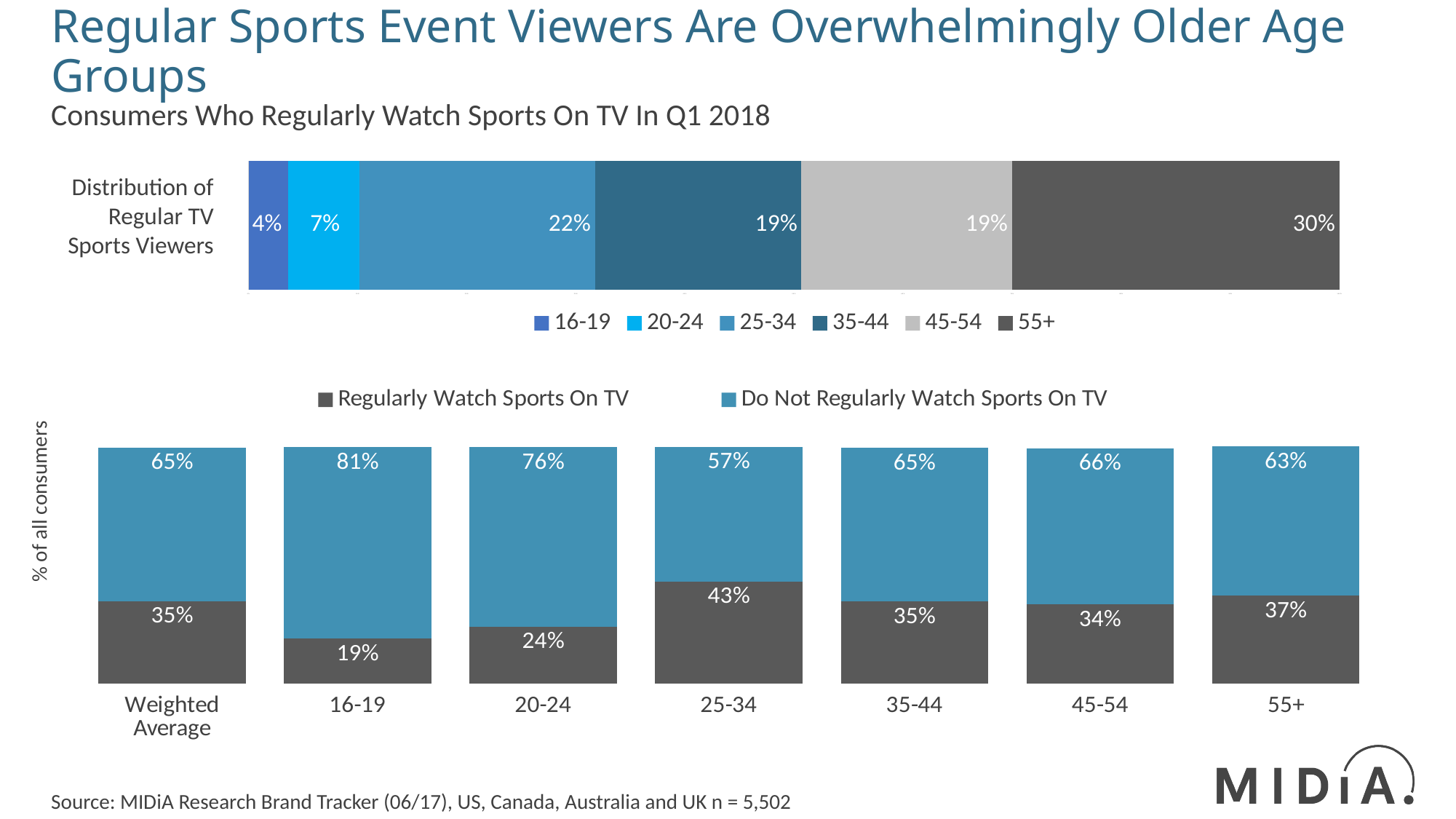
In the top chart (Distribution of Regular TV Sports Viewers), what is the difference between the 25-34 share and the 20-24 share? 15% In the bottom chart, what is the difference between the 'Regularly Watch Sports On TV' values for 55+ and 16-19? 18% In the bottom chart, what percentage of 25-34 year olds regularly watch sports on TV? 43% In the bottom chart, which age group has the highest percentage that regularly watch sports on TV? 25-34 In the top chart (Distribution of Regular TV Sports Viewers), which age group has the largest share? 55+ What kind of chart is the bottom chart? Stacked bar chart In the top chart (Distribution of Regular TV Sports Viewers), what share of regular TV sports viewers are aged 55+? 30% In the bottom chart, what percentage of 16-19 year olds do not regularly watch sports on TV? 81% In the top chart (Distribution of Regular TV Sports Viewers), which age group has the smallest share? 16-19 In the top chart (Distribution of Regular TV Sports Viewers), how many age groups does the legend list? 6 In the bottom chart, which age group has the lowest percentage that regularly watch sports on TV? 16-19 In the bottom chart, how many categories are shown on the x axis? 7